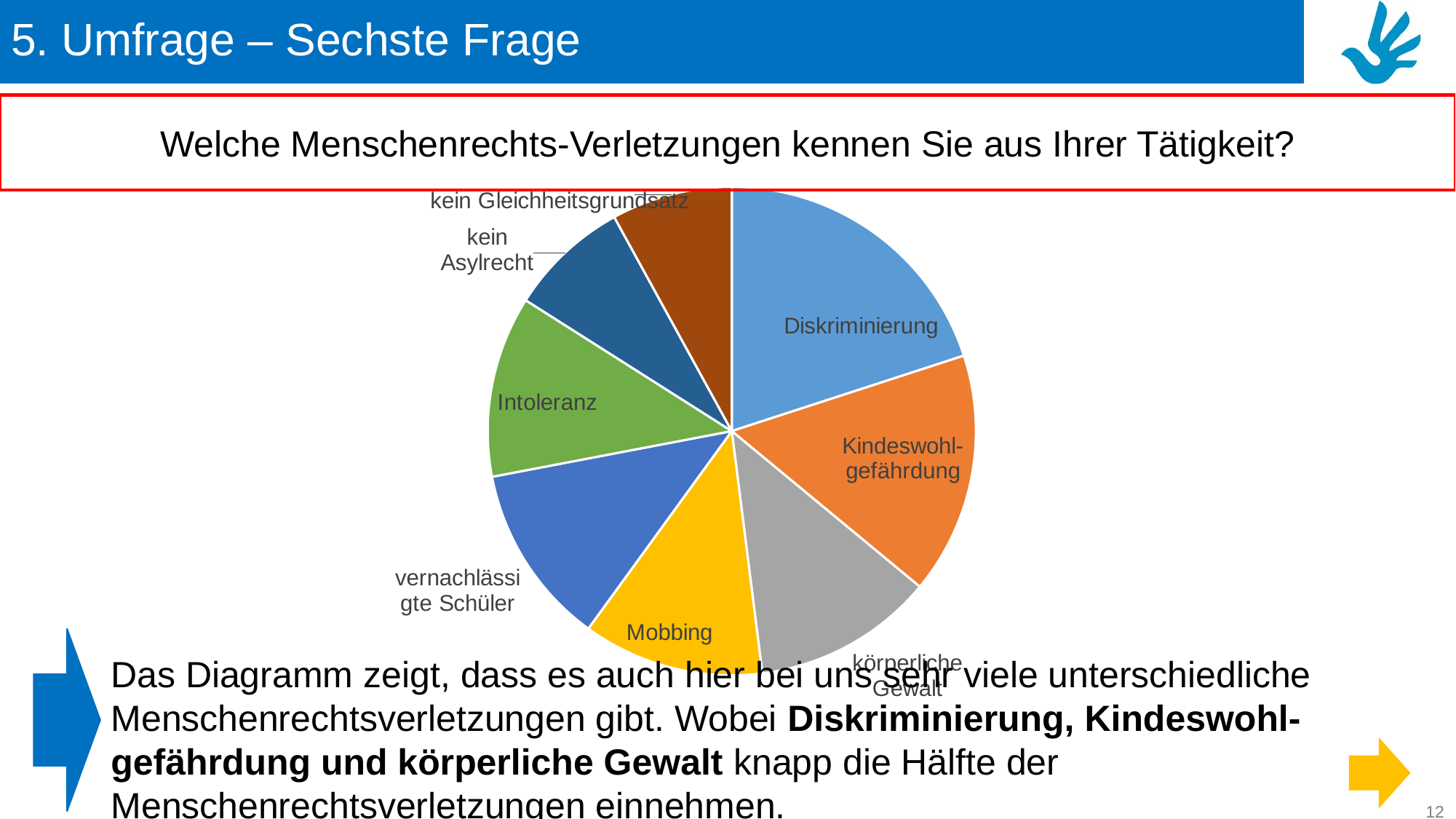
Which slice is larger, Kindeswohlgefährdung or Mobbing? Kindeswohlgefährdung What kind of chart is shown on the slide? pie chart Which slice is larger, Kindeswohlgefährdung or kein Gleichheitsgrundsatz? Kindeswohlgefährdung What colour is the Mobbing slice in the pie chart? yellow Which category is shown in green in the pie chart? Intoleranz How many slices does the pie chart have? 8 Which slice is larger, Diskriminierung or kein Asylrecht? Diskriminierung Which category has the largest slice in the pie chart? Diskriminierung